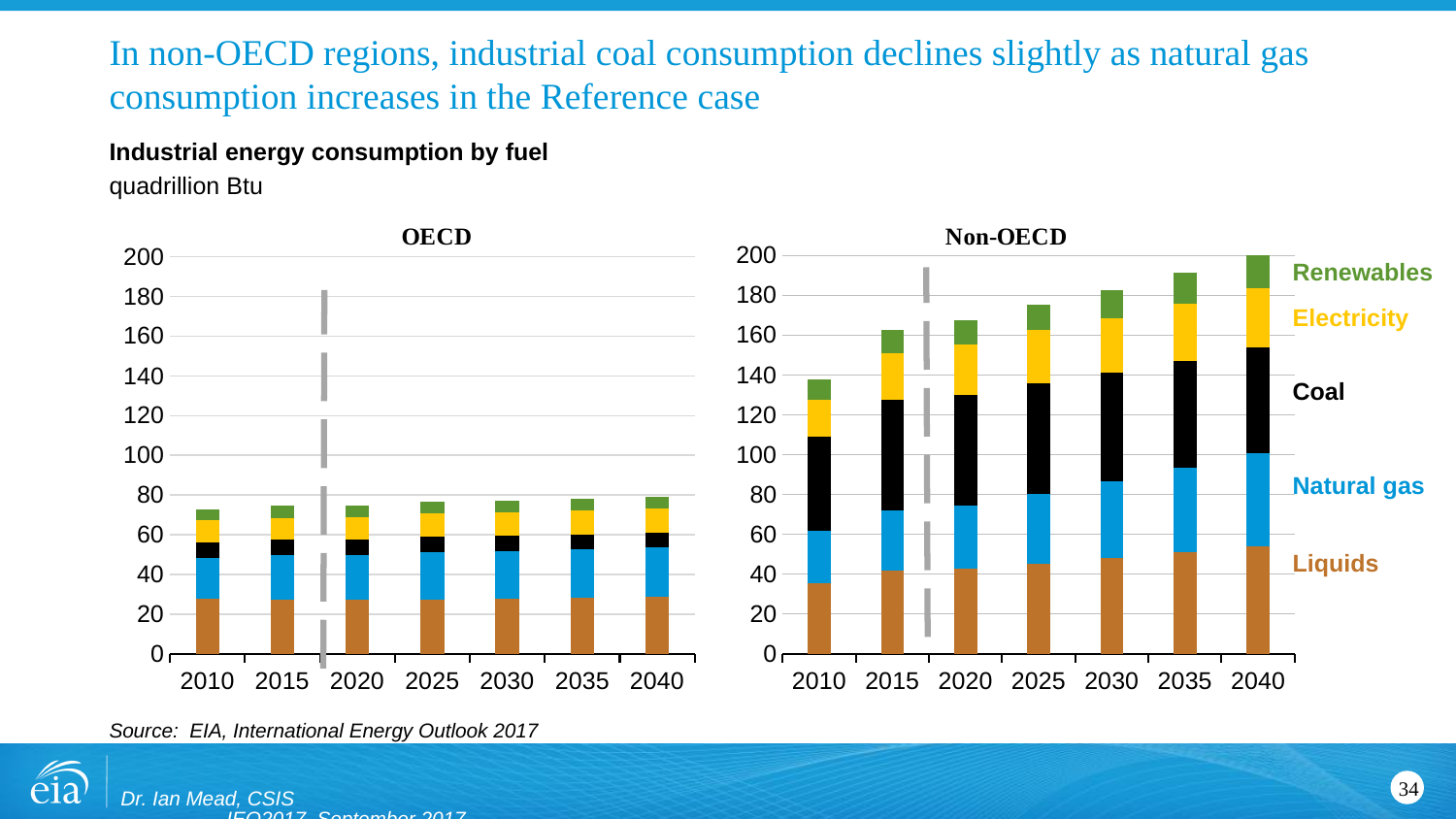
In the Non-OECD chart, which year has the highest total industrial energy consumption? 2040 In the Non-OECD chart, is the total for 2010 greater or less than 120? greater Which fuel series is shown at the bottom of each stacked bar? Liquids In the Non-OECD chart, do the total bar heights rise or fall from 2010 to 2040? rise In the OECD chart, is the total for 2010 greater or less than 80? less What kind of chart is the OECD chart? stacked bar chart In the Non-OECD chart, is the total for 2040 greater or less than 180? greater How many years are shown on the x axis of the Non-OECD chart? 7 Which is larger in 2040: the total for the OECD chart or the total for the Non-OECD chart? Non-OECD In the Non-OECD chart, which year has the lowest total industrial energy consumption? 2010 What unit is given for the industrial energy consumption charts? quadrillion Btu How many fuel series does the legend list for the charts? 5